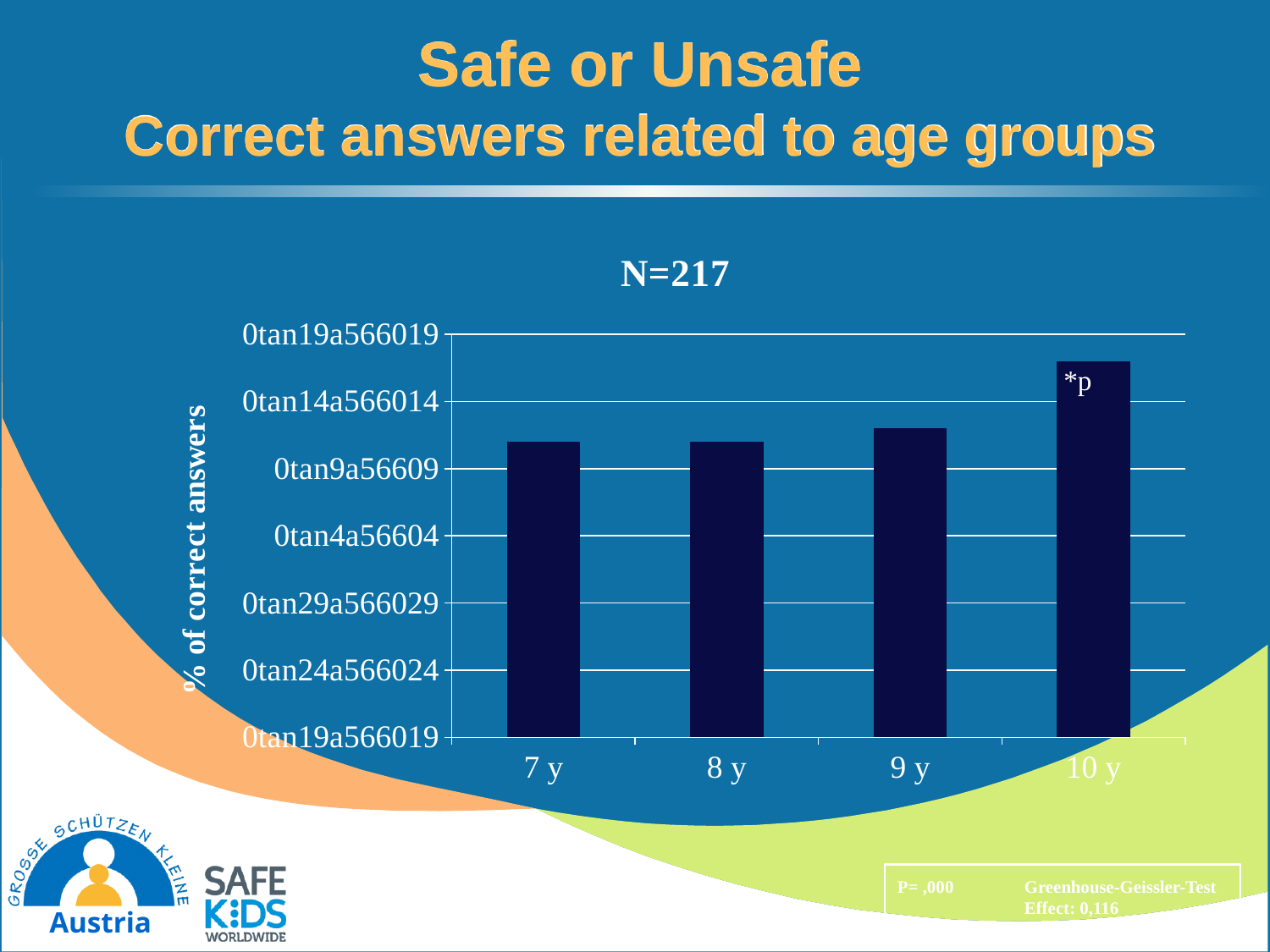
Which is larger, the value for 10 y or the value for 7 y? 10 y What are the category labels on the x axis, from left to right? 7 y, 8 y, 9 y, 10 y What kind of chart is shown on the slide? bar chart Do the values generally rise or fall as age increases along the x axis? rise Which is larger, the value for 9 y or the value for 7 y? 9 y Which bar is marked with the annotation "*p"? 10 y What is the title shown above the chart? N=217 What is the label on the y axis of the chart? % of correct answers How many age groups are plotted on the x axis? 4 Which age group has the highest percentage of correct answers? 10 y